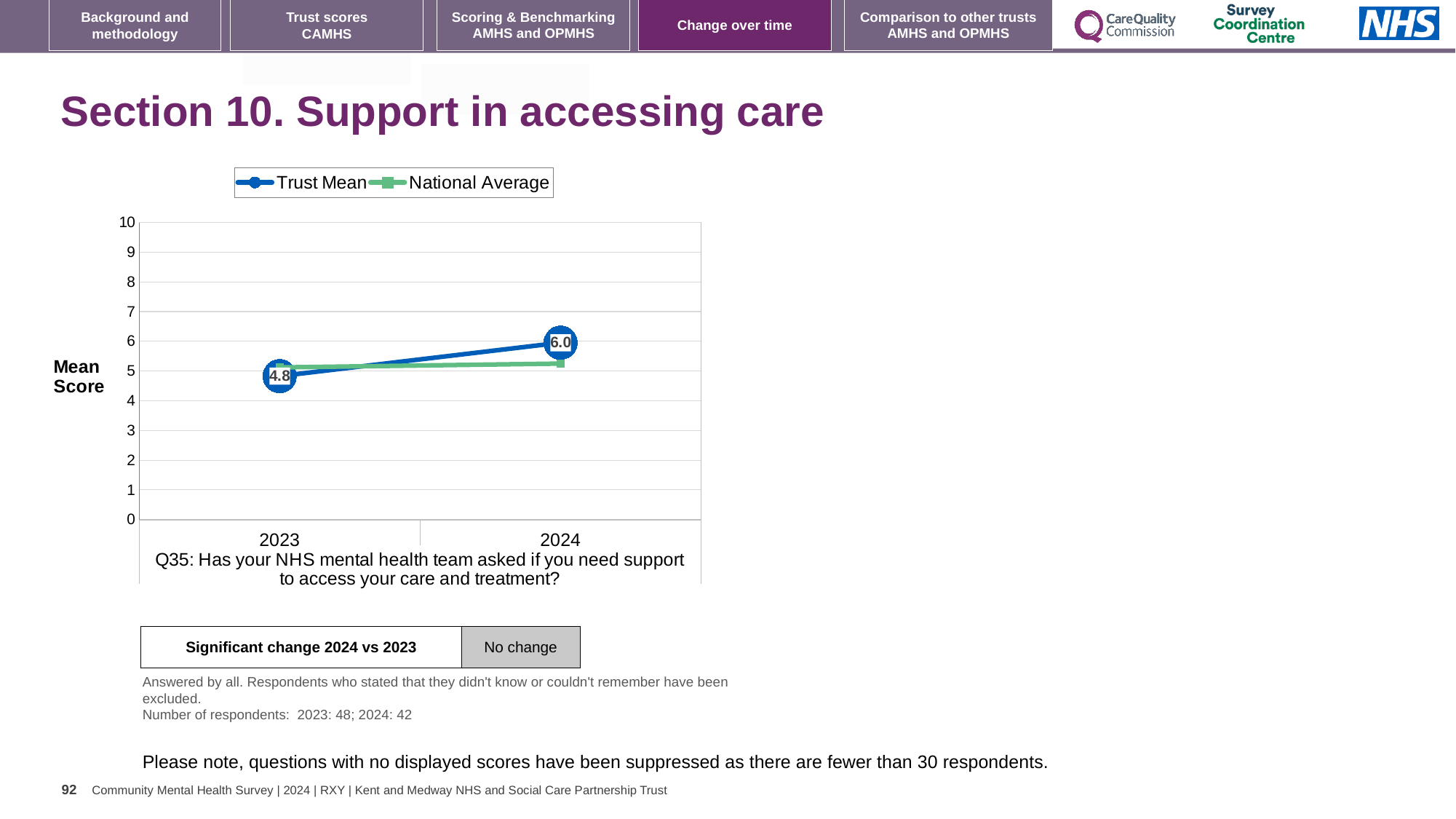
What is the label on the y axis of the chart? Mean Score Does the Trust Mean rise or fall from 2023 to 2024? rise What is the Trust Mean score for 2023? 4.8 What kind of chart is shown on the slide? line chart Is the National Average for 2024 greater or less than 6? less By how much did the Trust Mean change from 2023 to 2024? 1.2 Which year has the higher Trust Mean score, 2023 or 2024? 2024 In 2024, which is higher, the Trust Mean or the National Average? Trust Mean How many years are plotted on the x axis? 2 How many series does the legend list? 2 What is the Trust Mean score for 2024? 6.0